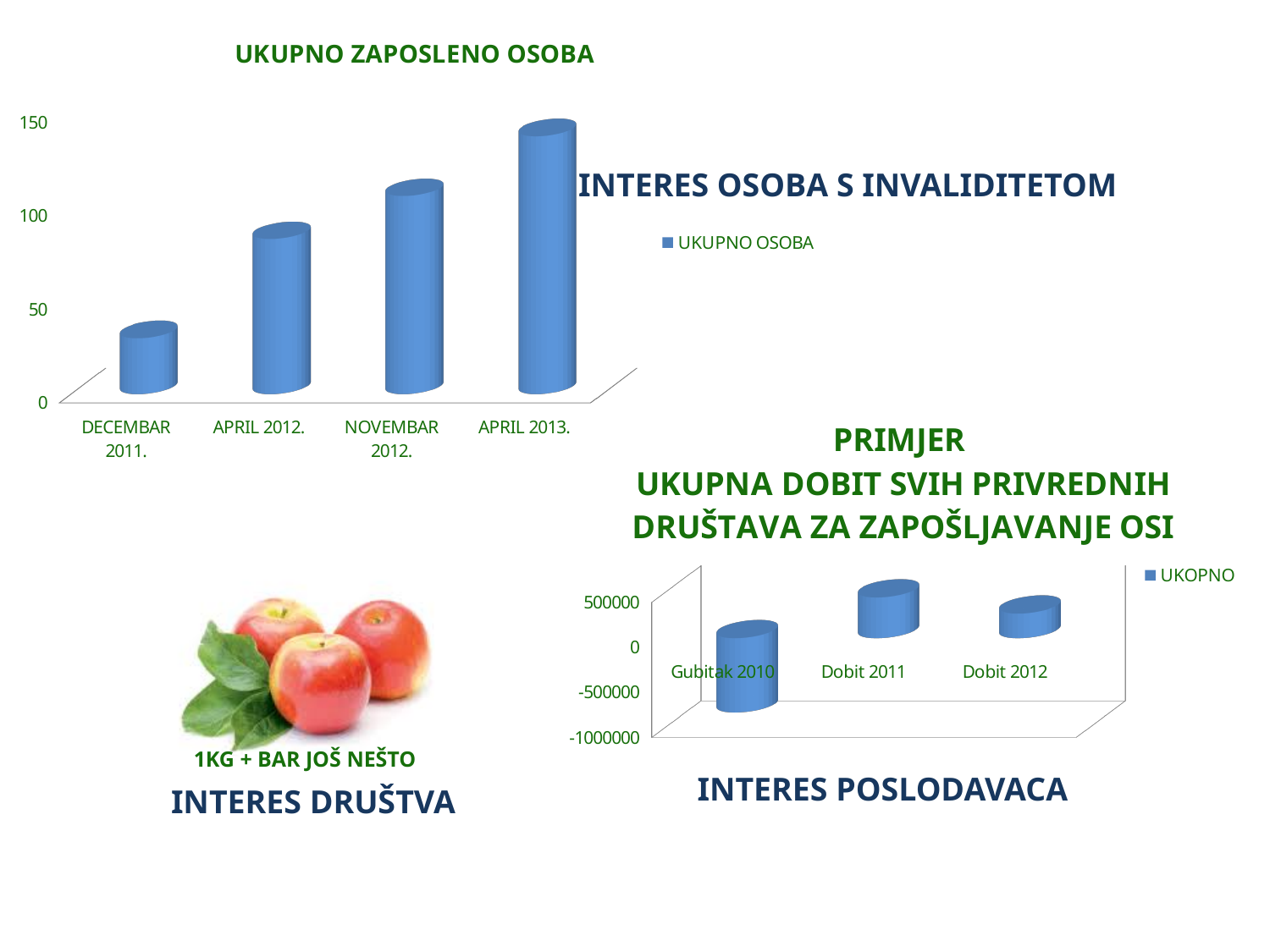
In the chart titled UKUPNO ZAPOSLENO OSOBA, which category has the lowest value? DECEMBAR 2011. In the chart titled UKUPNA DOBIT SVIH PRIVREDNIH DRUŠTAVA ZA ZAPOŠLJAVANJE OSI, which is larger, Dobit 2011 or Dobit 2012? Dobit 2011 In the chart titled UKUPNO ZAPOSLENO OSOBA, which category has the highest value? APRIL 2013. What kind of chart is the chart titled UKUPNO ZAPOSLENO OSOBA? bar chart In the chart titled UKUPNO ZAPOSLENO OSOBA, do the values rise or fall from DECEMBAR 2011. to APRIL 2013.? rise How many categories are shown in the chart titled UKUPNO ZAPOSLENO OSOBA? 4 In the chart titled UKUPNO ZAPOSLENO OSOBA, is the value for NOVEMBAR 2012. greater or less than 100? greater What series name does the legend show for the chart titled UKUPNA DOBIT SVIH PRIVREDNIH DRUŠTAVA ZA ZAPOŠLJAVANJE OSI? UKOPNO In the chart titled UKUPNA DOBIT SVIH PRIVREDNIH DRUŠTAVA ZA ZAPOŠLJAVANJE OSI, is the value for Gubitak 2010 greater or less than 0? less How many categories are shown in the chart titled UKUPNA DOBIT SVIH PRIVREDNIH DRUŠTAVA ZA ZAPOŠLJAVANJE OSI? 3 In the chart titled UKUPNO ZAPOSLENO OSOBA, is the value for APRIL 2012. greater or less than 100? less